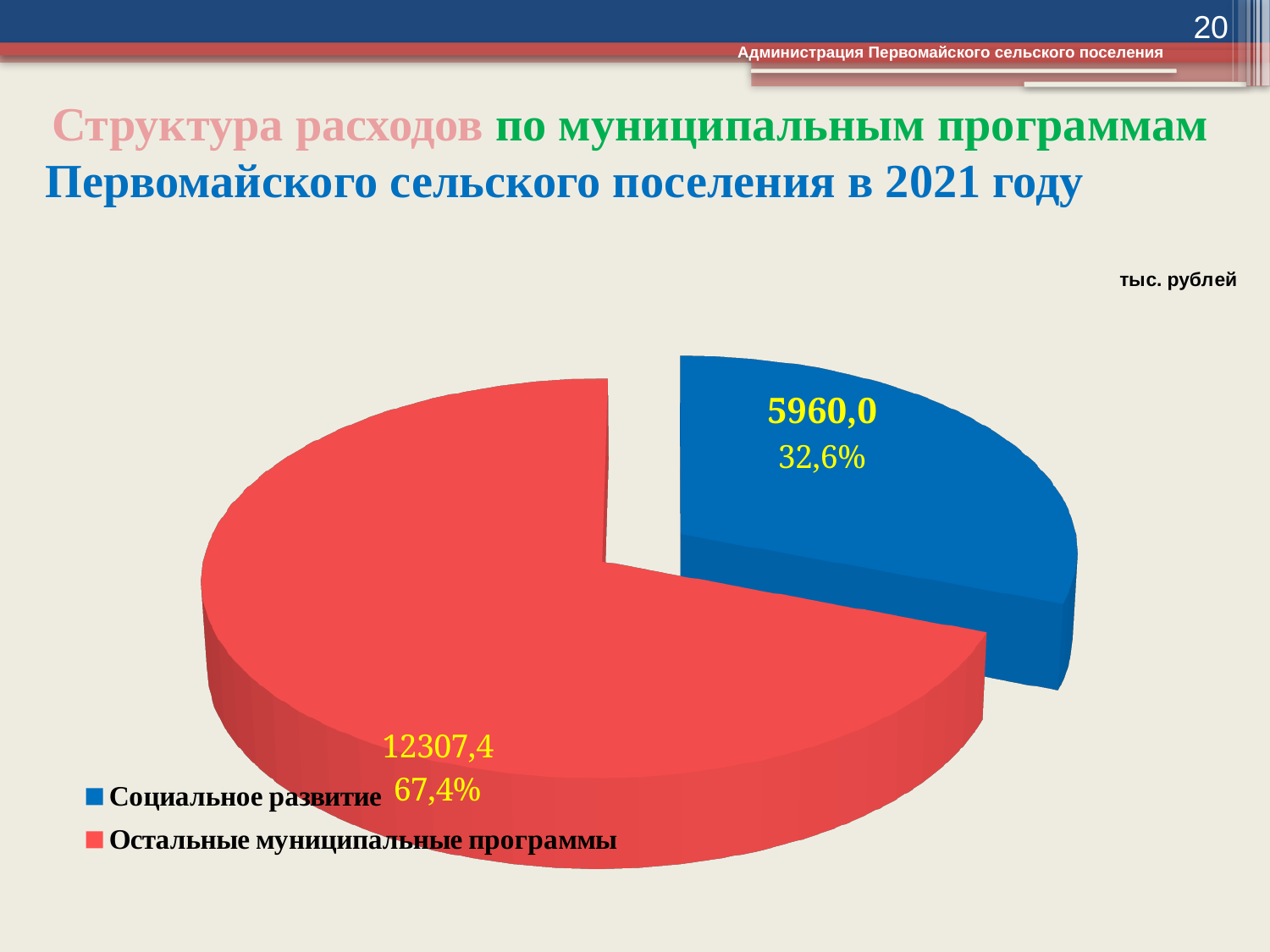
What unit is indicated for the chart values? тыс. рублей What share of the pie does Социальное развитие represent? 32,6% What kind of chart is shown on the slide? Pie chart How many slices does the pie chart have? 2 Which is larger: Социальное развитие or Остальные муниципальные программы? Остальные муниципальные программы What is the difference between Остальные муниципальные программы and Социальное развитие? 6347,4 What is the value for Социальное развитие? 5960,0 What is the value for Остальные муниципальные программы? 12307,4 What colour is the slice for Социальное развитие? Blue What share of the pie does Остальные муниципальные программы represent? 67,4% Which category has the smallest slice? Социальное развитие Which category has the largest slice? Остальные муниципальные программы